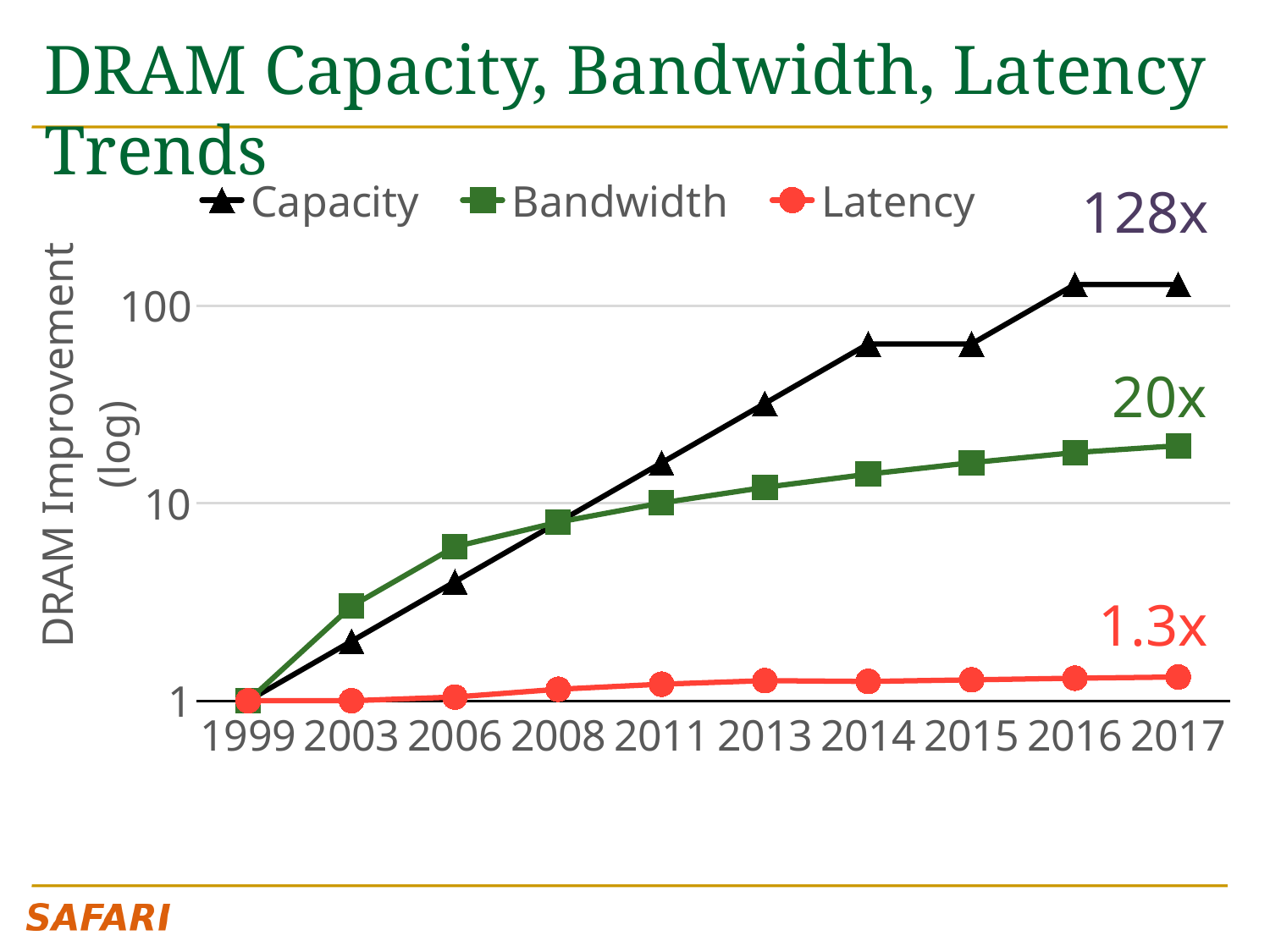
Which series has the lowest value in 2017? Latency Which series has the highest value in 2017? Capacity Does the Capacity series rise or fall from 1999 to 2017? rise What improvement factor is labelled for Capacity in 2017? 128x How many years are labelled along the x axis? 10 In 2006, which is larger, the Bandwidth value or the Capacity value? Bandwidth What improvement factor is labelled for Bandwidth in 2017? 20x What improvement factor is labelled for Latency in 2017? 1.3x How many series does the legend list? 3 What kind of chart is shown on the slide? line chart What is the label on the y axis? DRAM Improvement (log) Is the Capacity value for 2016 greater or less than 100? greater